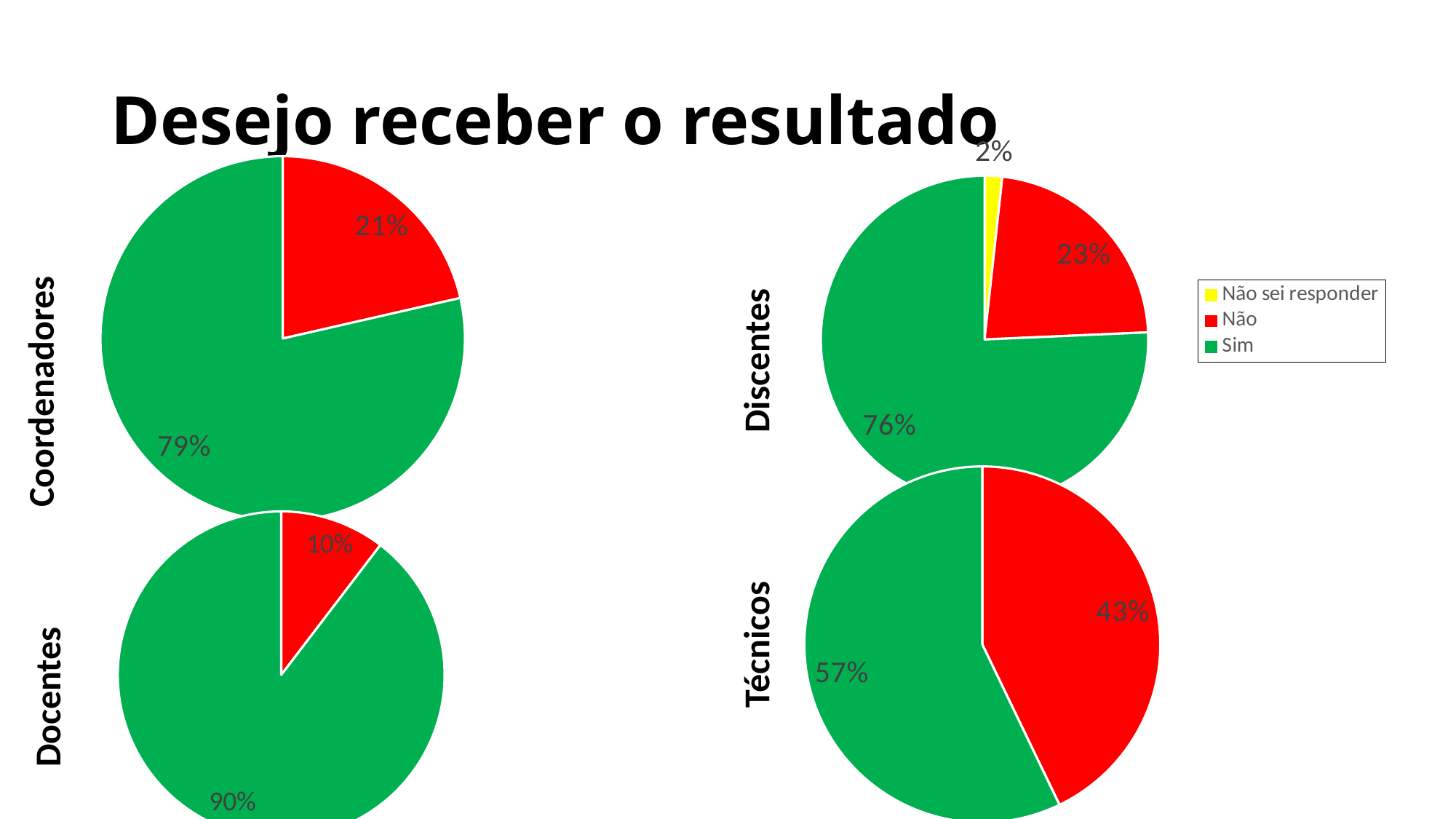
In the Técnicos pie chart, what share of respondents answered Sim? 57% In the Docentes pie chart, what share of respondents answered Não? 10% In the Técnicos pie chart, what is the difference between the Sim and Não shares? 14% In the Coordenadores pie chart, what share of respondents answered Sim? 79% How many entries does the legend list? 3 Which group's pie chart has the largest Sim share: Docentes or Discentes? Docentes In the Técnicos pie chart, which answer has the largest slice? Sim How many slices does the Discentes pie chart have? 3